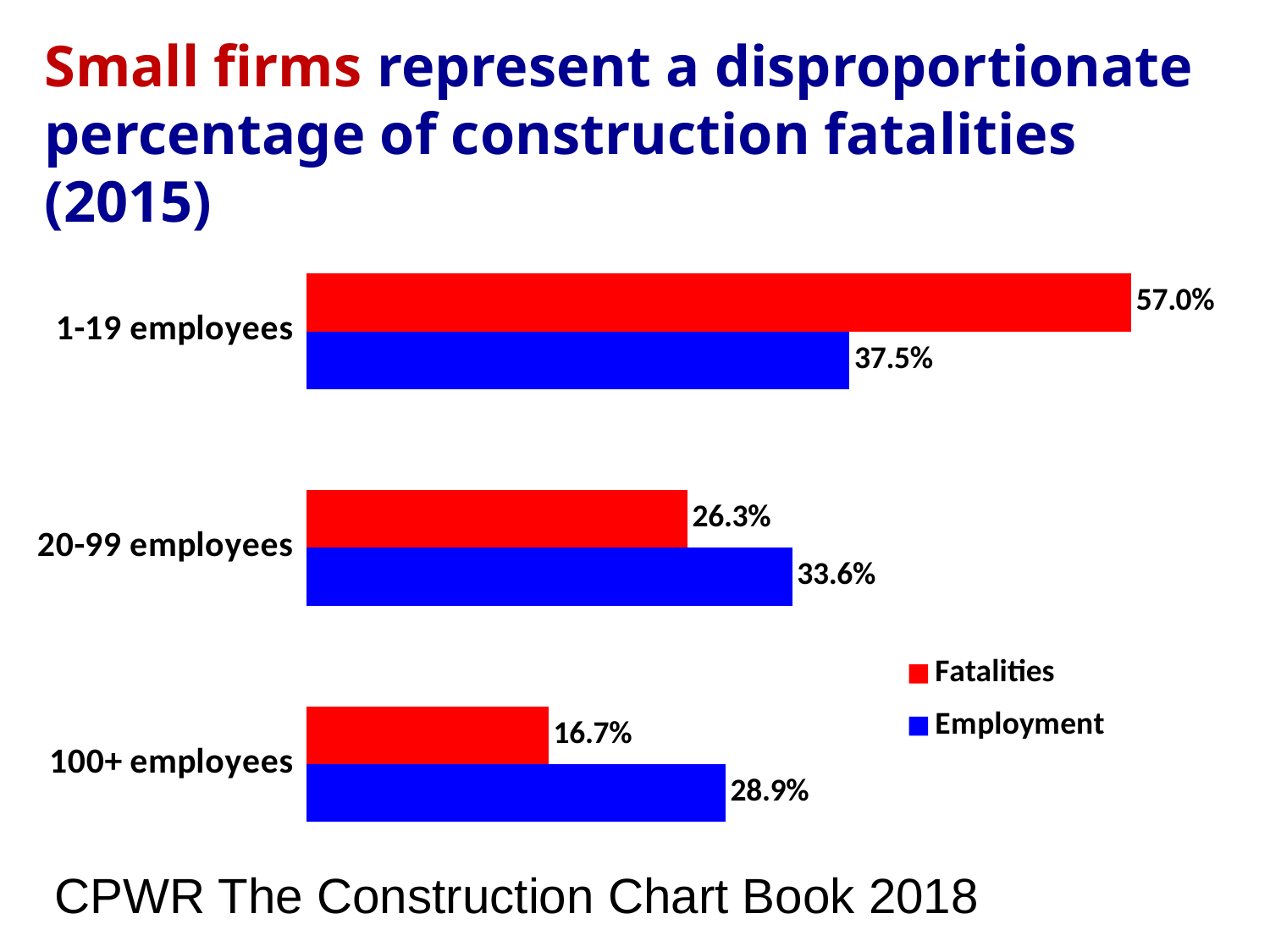
For 20-99 employees, which is larger: Fatalities or Employment? Employment Which firm size category has the lowest Employment value? 100+ employees Which colour represents the Employment series? Blue What is the Employment value for 20-99 employees? 33.6% What is the difference between the Fatalities and Employment values for 1-19 employees? 19.5% How many firm size categories are shown in the chart? 3 Which firm size category has the highest Fatalities value? 1-19 employees What is the Fatalities value for 1-19 employees? 57.0% How many series does the legend list? 2 What is the Fatalities value for 100+ employees? 16.7% What type of chart is shown on the slide? Bar chart What is the Employment value for 100+ employees? 28.9%